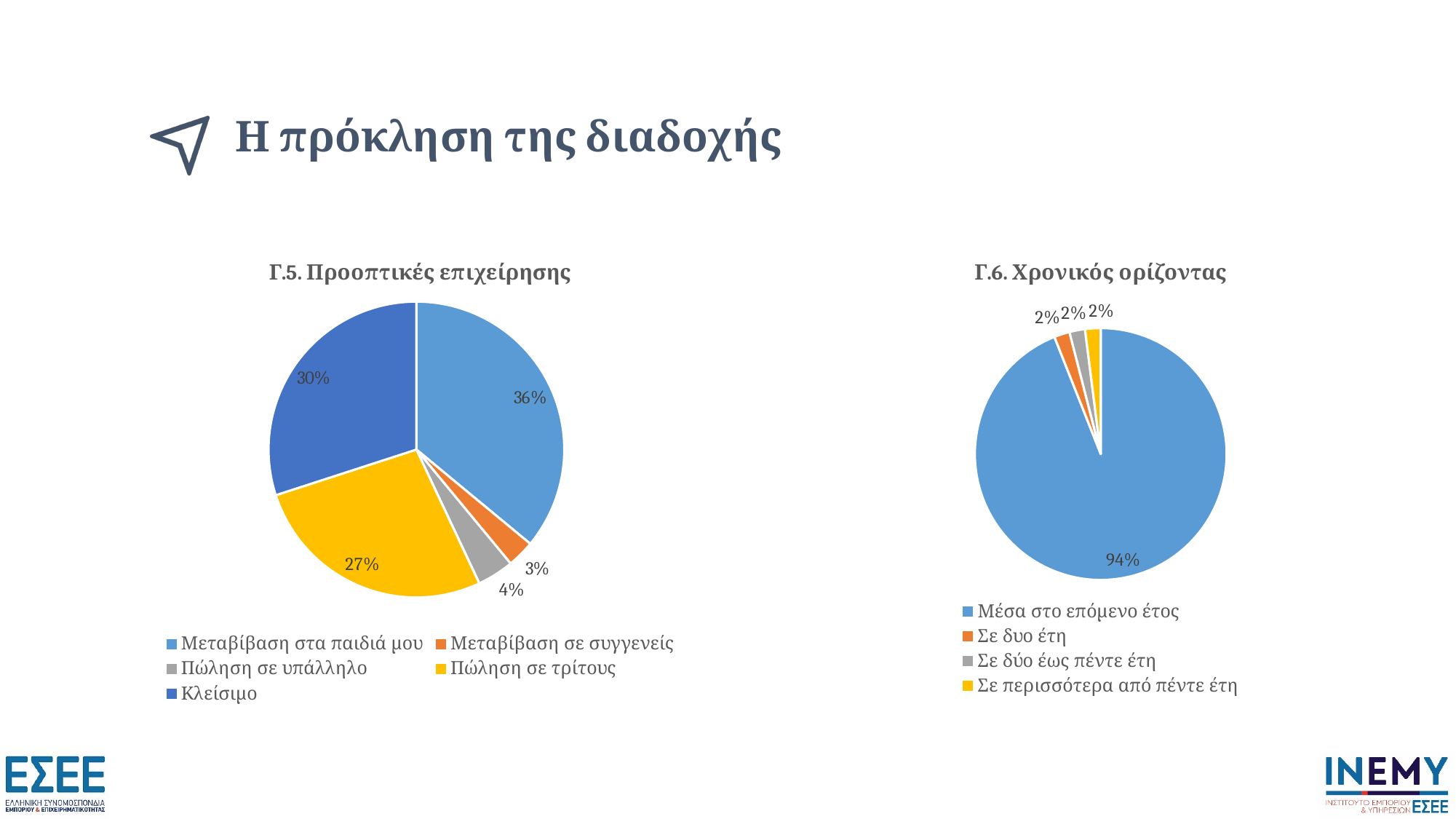
In the chart titled Γ.5. Προοπτικές επιχείρησης, what is the difference between the shares of Κλείσιμο and Πώληση σε τρίτους? 3% How many categories does the chart titled Γ.6. Χρονικός ορίζοντας show? 4 In the chart titled Γ.5. Προοπτικές επιχείρησης, what share does Κλείσιμο have? 30% What type of chart is the chart titled Γ.6. Χρονικός ορίζοντας? Pie chart In the chart titled Γ.5. Προοπτικές επιχείρησης, what share does Πώληση σε τρίτους have? 27% In the chart titled Γ.6. Χρονικός ορίζοντας, what share does Μέσα στο επόμενο έτος have? 94% How many categories does the chart titled Γ.5. Προοπτικές επιχείρησης show? 5 In the chart titled Γ.5. Προοπτικές επιχείρησης, which category has the smallest slice? Μεταβίβαση σε συγγενείς In the chart titled Γ.5. Προοπτικές επιχείρησης, which is larger: Πώληση σε υπάλληλο or Μεταβίβαση σε συγγενείς? Πώληση σε υπάλληλο In the chart titled Γ.5. Προοπτικές επιχείρησης, which category has the largest slice? Μεταβίβαση στα παιδιά μου